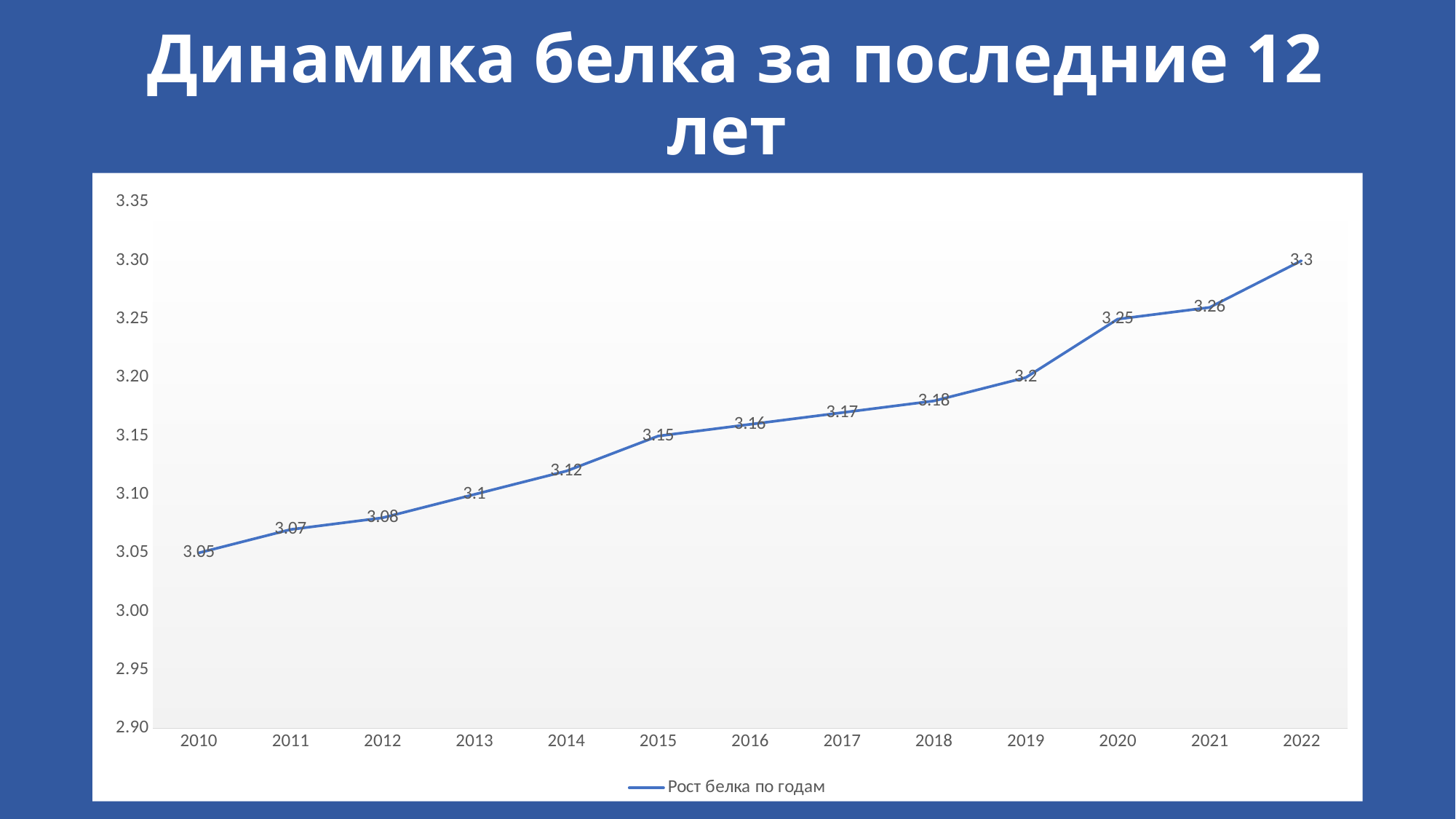
Which is larger, the value for 2014 or the value for 2018? 2018 Which year has the lowest value? 2010 What is the value for 2016? 3.16 Do the values rise or fall from 2010 to 2022? rise What kind of chart is shown? line chart How many years are plotted on the x axis? 13 What is the value for 2010? 3.05 What is the value for 2022? 3.3 What is the difference between the values for 2022 and 2010? 0.25 What is the difference between the values for 2020 and 2019? 0.05 Which year has the highest value? 2022 Is the value for 2021 greater or less than 3.20? greater